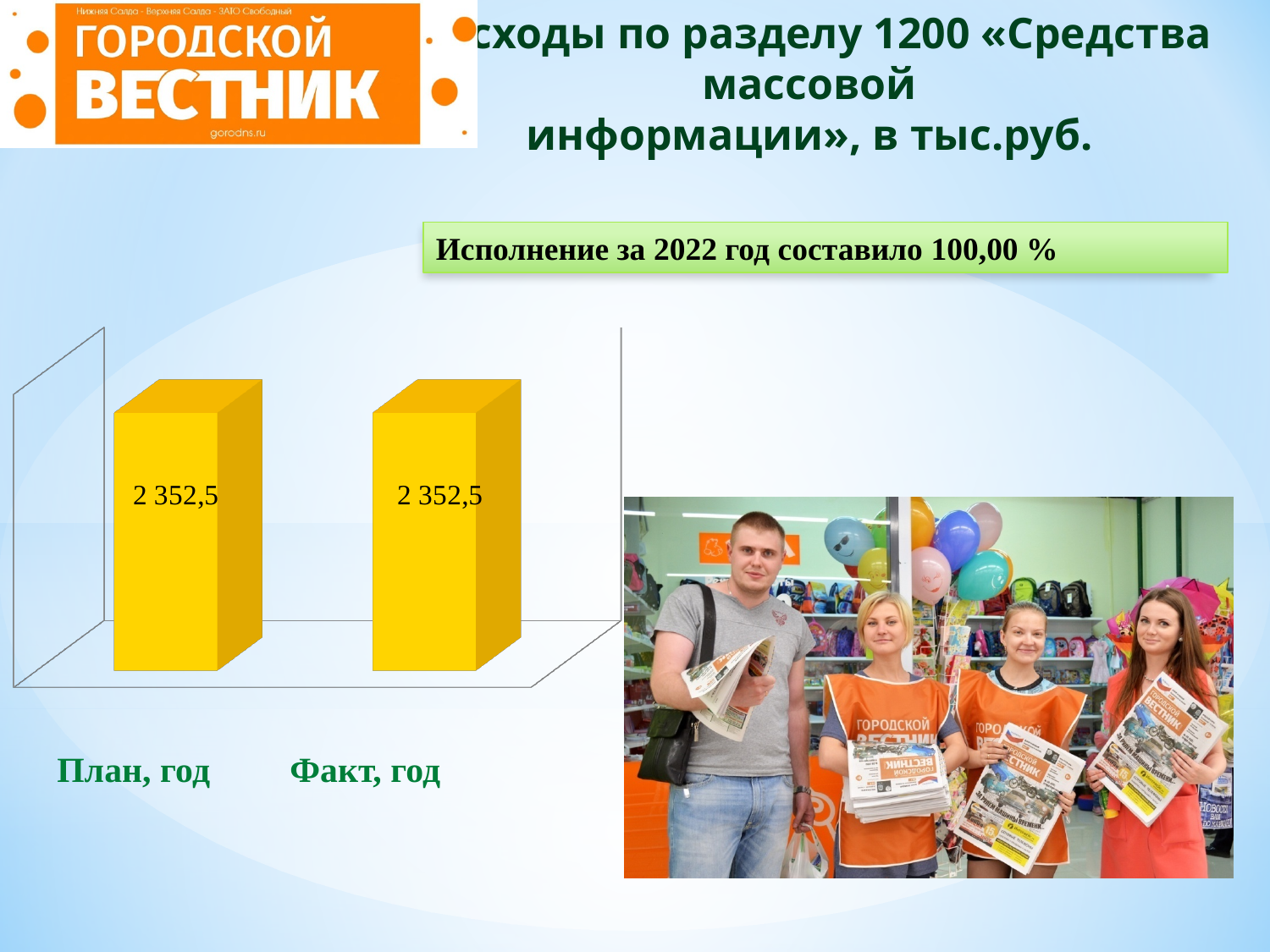
What are the labels of the two categories in the chart? План, год; Факт, год What is the difference between the values for «План, год» and «Факт, год»? 0 What is the value for «Факт, год»? 2 352,5 What kind of chart is shown on the slide? bar chart What is the value for «План, год»? 2 352,5 How many categories are shown in the chart? 2 What is the total of the two values shown in the chart? 4 705,0 What colour are the bars in the chart? yellow Is the value for «Факт, год» larger than, smaller than, or equal to the value for «План, год»? equal